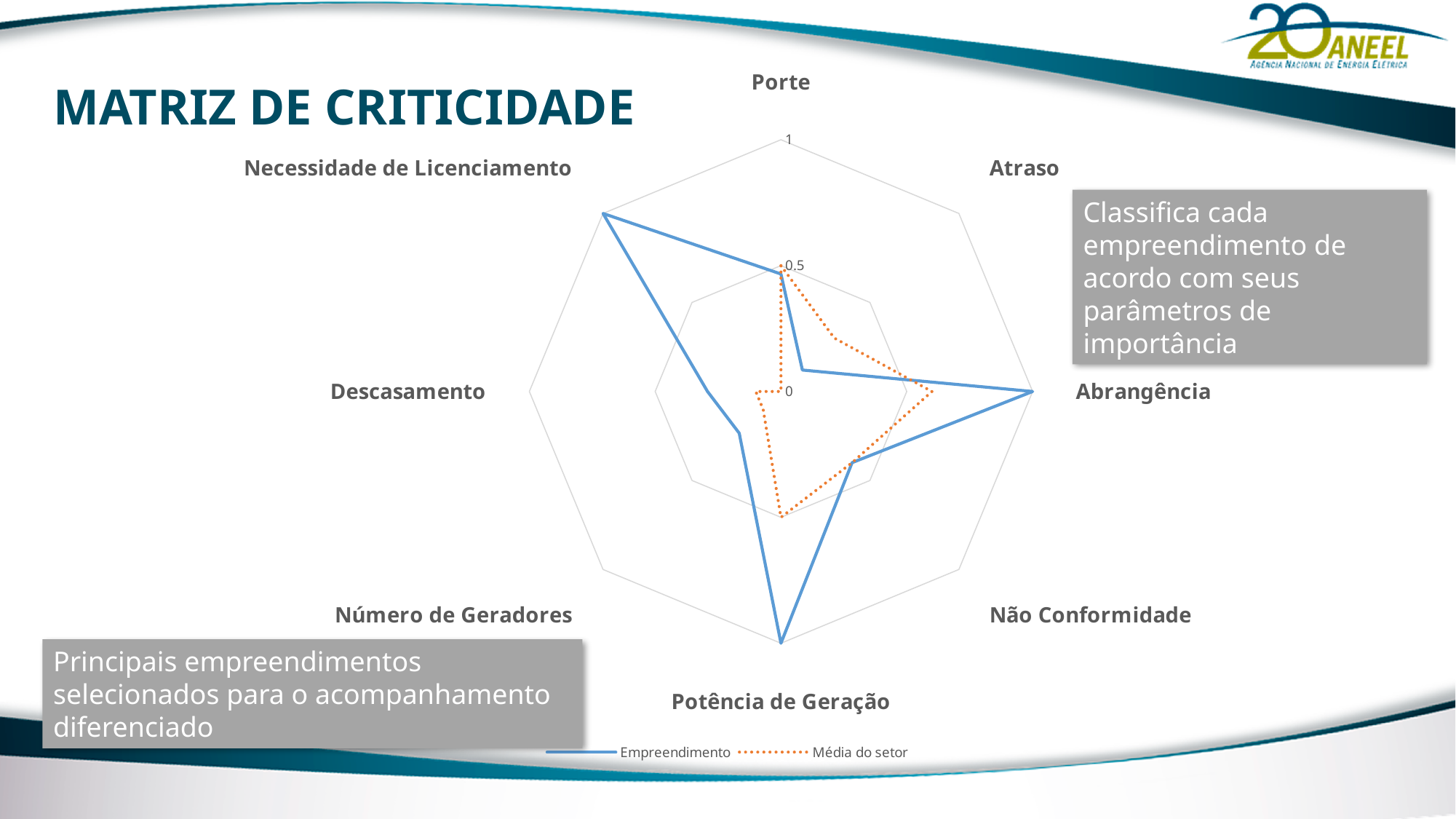
Is the Empreendimento value for Potência de Geração greater or less than 0.5? greater Is the Média do setor value for Descasamento greater or less than 0.5? less Which series is drawn with a dotted line? Média do setor How many series does the chart legend list? 2 How many categories (axes) does the radar chart have? 8 Is the Empreendimento value for Necessidade de Licenciamento greater or less than 0.5? greater For Necessidade de Licenciamento, which series has the larger value, Empreendimento or Média do setor? Empreendimento For Abrangência, which series has the larger value, Empreendimento or Média do setor? Empreendimento Which two series are listed in the chart legend? Empreendimento and Média do setor What kind of chart is shown on the slide? Radar chart